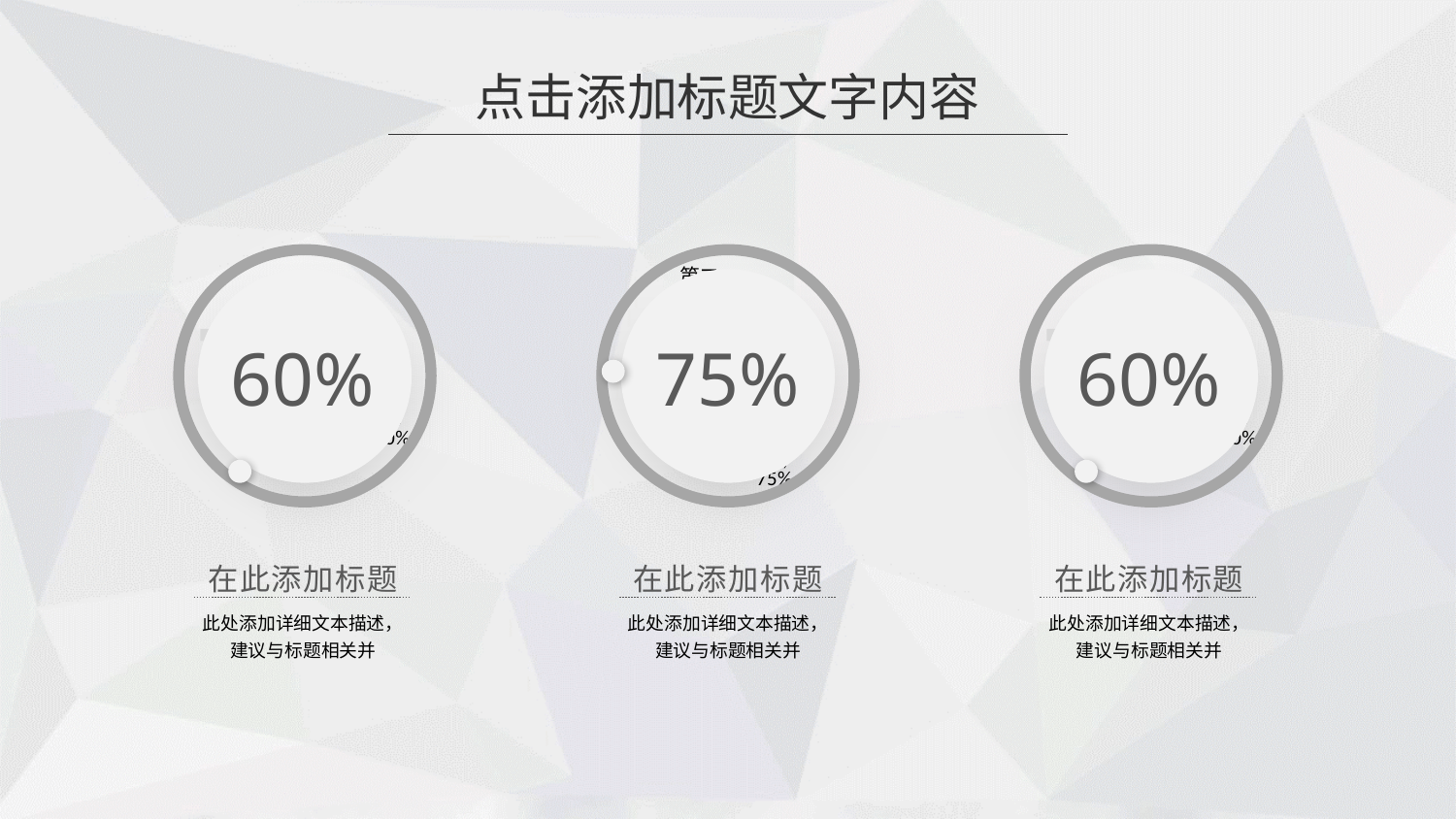
What percentage is shown in the middle circular chart? 75% Which of the three circular charts shows the highest percentage: left, middle, or right? middle What is the title text at the top of the slide? 点击添加标题文字内容 Is the value in the middle circular chart greater or less than 50%? greater What is the difference in percentage points between the middle circular chart and the left circular chart? 15 Is the percentage in the middle circular chart larger or smaller than the percentage in the left circular chart? larger What percentage is shown in the left circular chart? 60% How many circular charts are on the slide? 3 What kind of chart is used to display the percentages on the slide? doughnut (ring) chart What is the heading text shown below each circular chart? 在此添加标题 What percentage is shown in the right circular chart? 60% Do the left and right circular charts show the same percentage? Yes